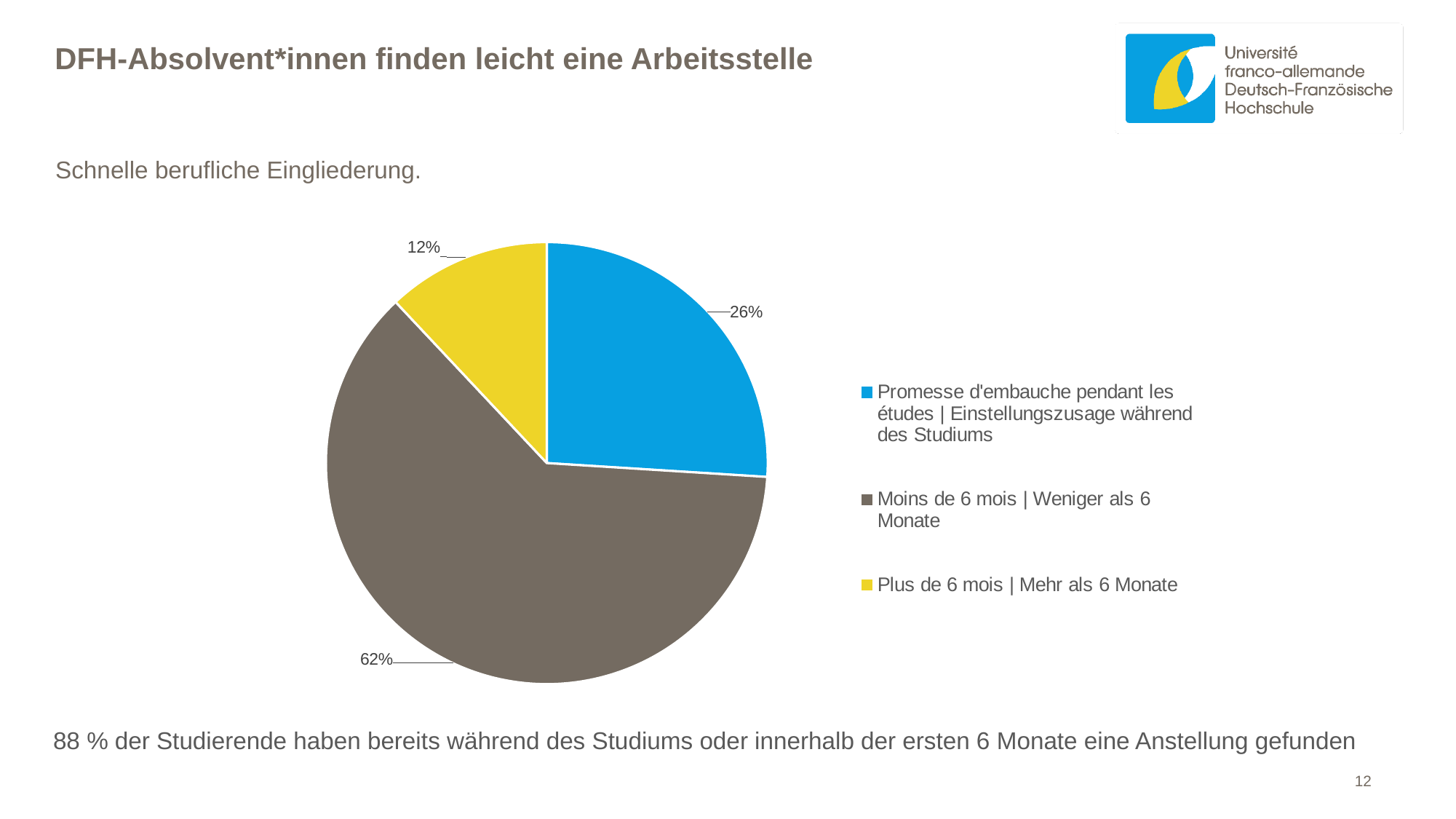
What is the difference in percentage points between the 'Weniger als 6 Monate' slice and the 'Einstellungszusage während des Studiums' slice? 36 percentage points What share of the pie is labelled 'Plus de 6 mois | Mehr als 6 Monate'? 12% What is the combined share of the 'Einstellungszusage während des Studiums' and 'Weniger als 6 Monate' slices? 88% What share of the pie is labelled 'Promesse d'embauche pendant les études | Einstellungszusage während des Studiums'? 26% Which category has the smallest slice of the pie? Plus de 6 mois | Mehr als 6 Monate What colour is the slice for 'Plus de 6 mois | Mehr als 6 Monate'? Yellow What share of the pie is labelled 'Moins de 6 mois | Weniger als 6 Monate'? 62% How many slices does the pie chart have? 3 Which is larger: the 'Einstellungszusage während des Studiums' slice or the 'Mehr als 6 Monate' slice? Einstellungszusage während des Studiums How many entries does the legend list? 3 Which category has the largest slice of the pie? Moins de 6 mois | Weniger als 6 Monate What kind of chart is shown on the slide? Pie chart